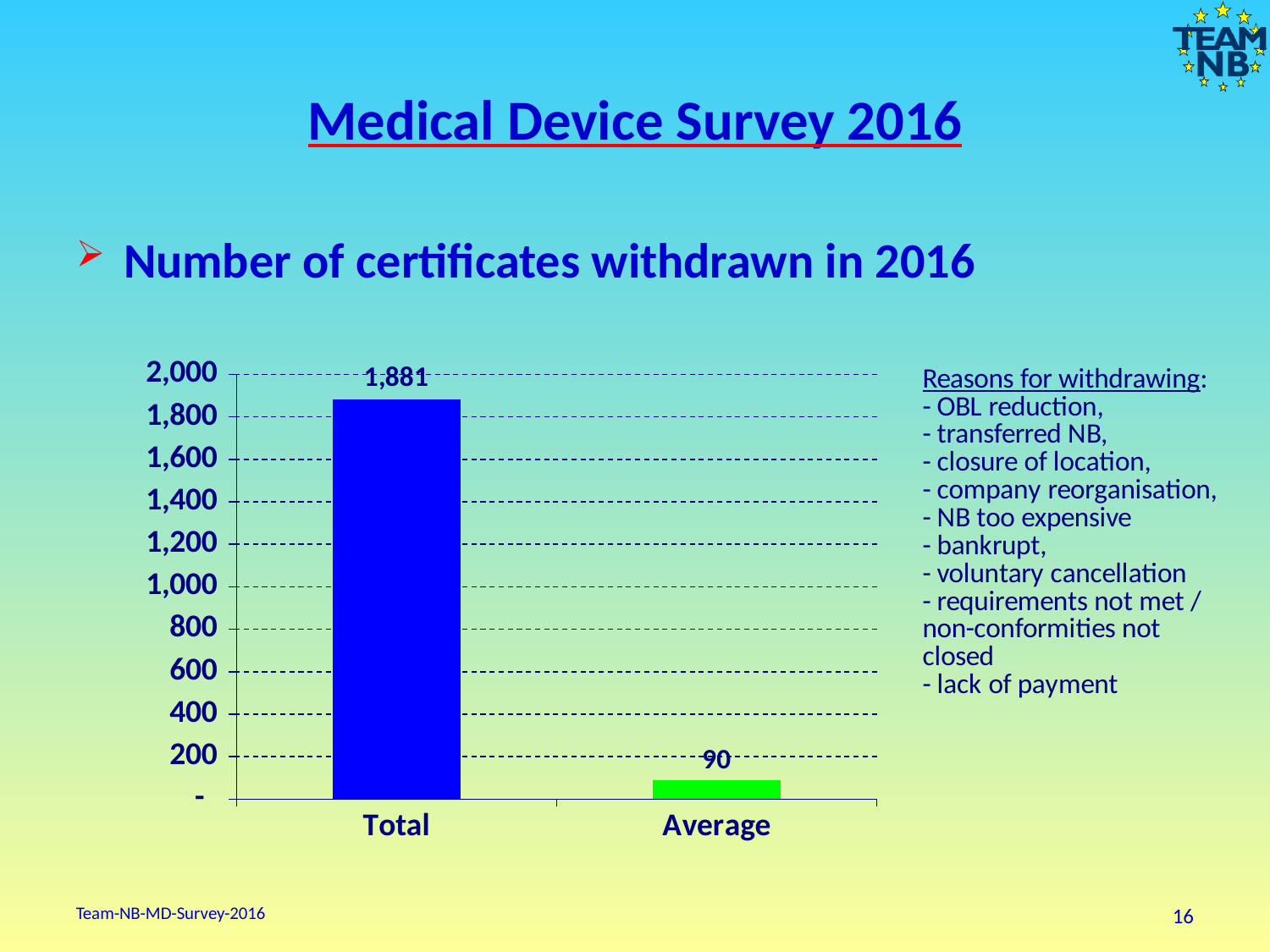
Which is larger, the Total value or the Average value? Total What kind of chart is shown on the slide? bar chart Is the value for Total greater or less than 1,800? greater How many categories are shown on the x axis? 2 What colour is the Average bar? green Which category has the highest value? Total What is the value of the Total bar? 1,881 Which category has the lowest value? Average What is the value of the Average bar? 90 Is the value for Average greater or less than 200? less What is the difference between the Total and Average values? 1,791 What is the maximum value shown on the y axis? 2,000